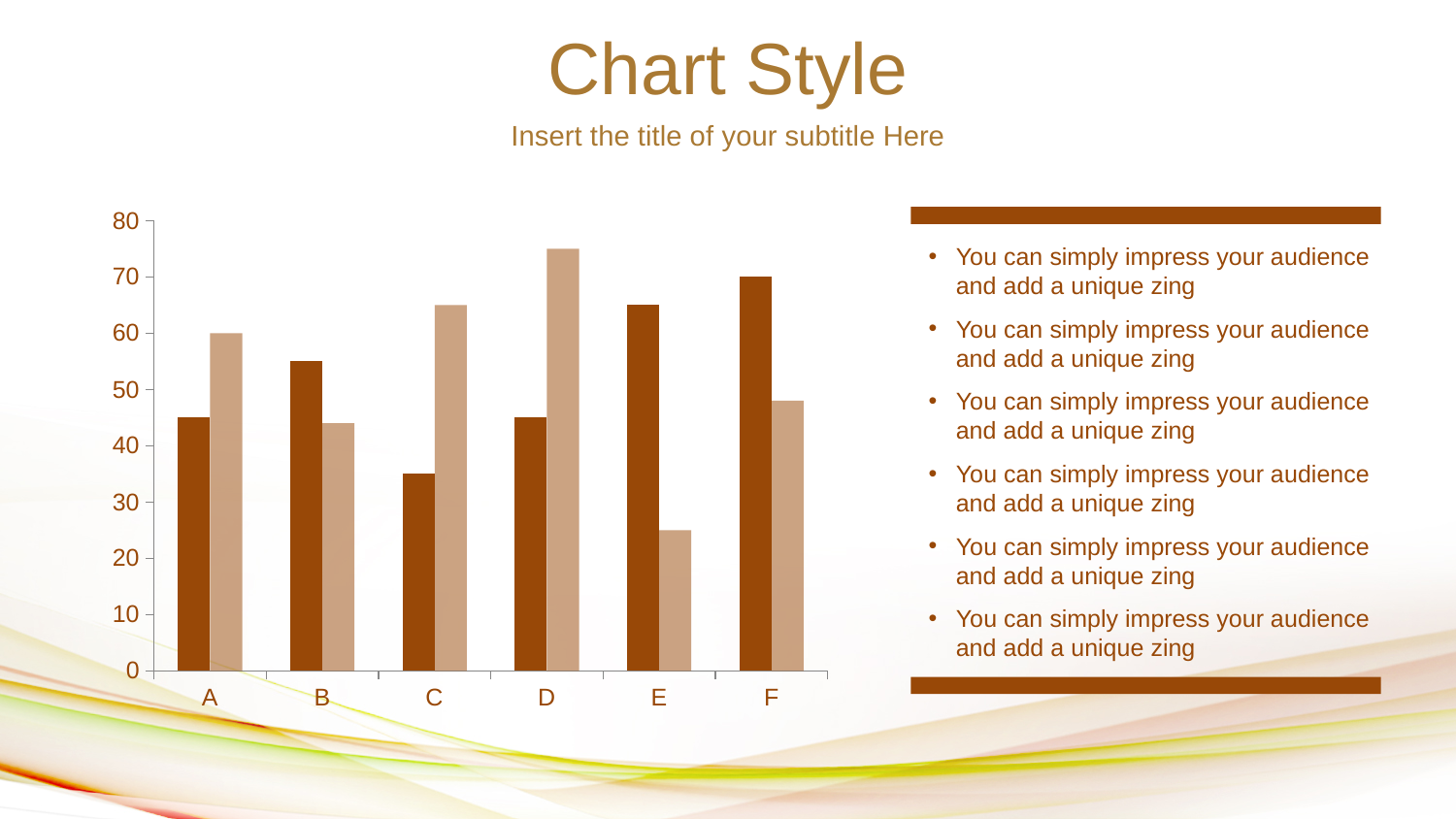
How many bars are plotted for each category in the chart? 2 For category E, which bar is taller, the dark brown bar or the light tan bar? dark brown Which category has the shortest dark brown bar? C Which category has the tallest dark brown bar? F How many categories are shown on the x axis of the chart? 6 Is the value of the dark brown bar for E greater or less than 60? greater Is the value of the light tan bar for D greater or less than 70? greater Which category has the shortest light tan bar? E For category C, which bar is taller, the dark brown bar or the light tan bar? light tan Which category has the tallest light tan bar? D Is the value of the light tan bar for E greater or less than 30? less What kind of chart is shown on the slide? bar chart